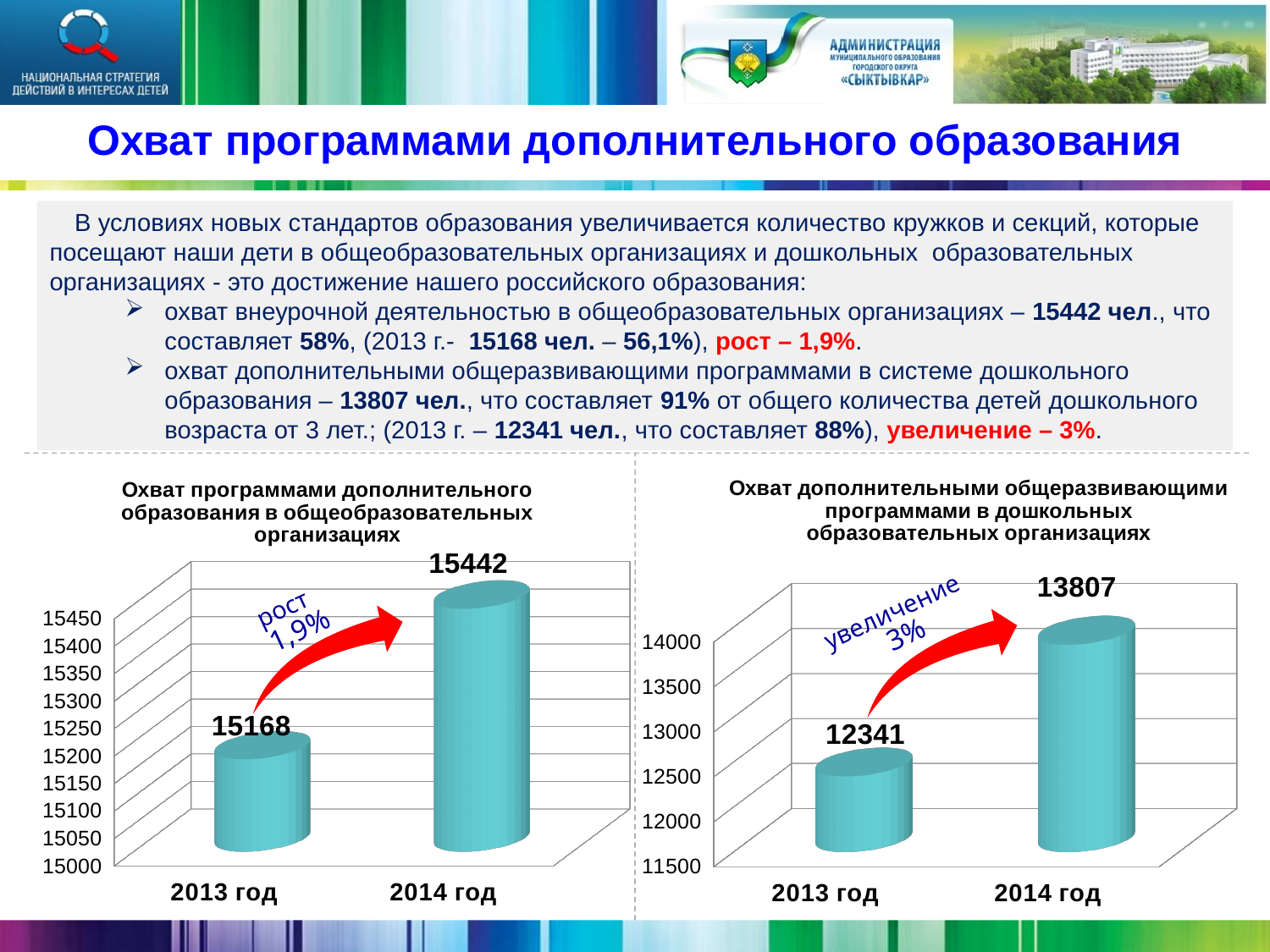
In the right chart (Охват дополнительными общеразвивающими программами в дошкольных образовательных организациях), what is the value for 2014 год? 13807 How many categories are shown on the x axis of the left chart? 2 In the right chart, is the value for 2013 год greater or less than 12500? less In the right chart (Охват дополнительными общеразвивающими программами в дошкольных образовательных организациях), what is the value for 2013 год? 12341 In the left chart (Охват программами дополнительного образования в общеобразовательных организациях), what is the value for 2014 год? 15442 In the left chart (Охват программами дополнительного образования в общеобразовательных организациях), what is the value for 2013 год? 15168 In the left chart, which year has the higher value? 2014 год In the right chart, which year has the lower value? 2013 год In the right chart, what is the difference between the 2014 год and 2013 год values? 1466 What kind of chart is the right chart? bar chart In the left chart, do the values rise or fall from 2013 год to 2014 год? rise In the left chart, what is the difference between the 2014 год and 2013 год values? 274